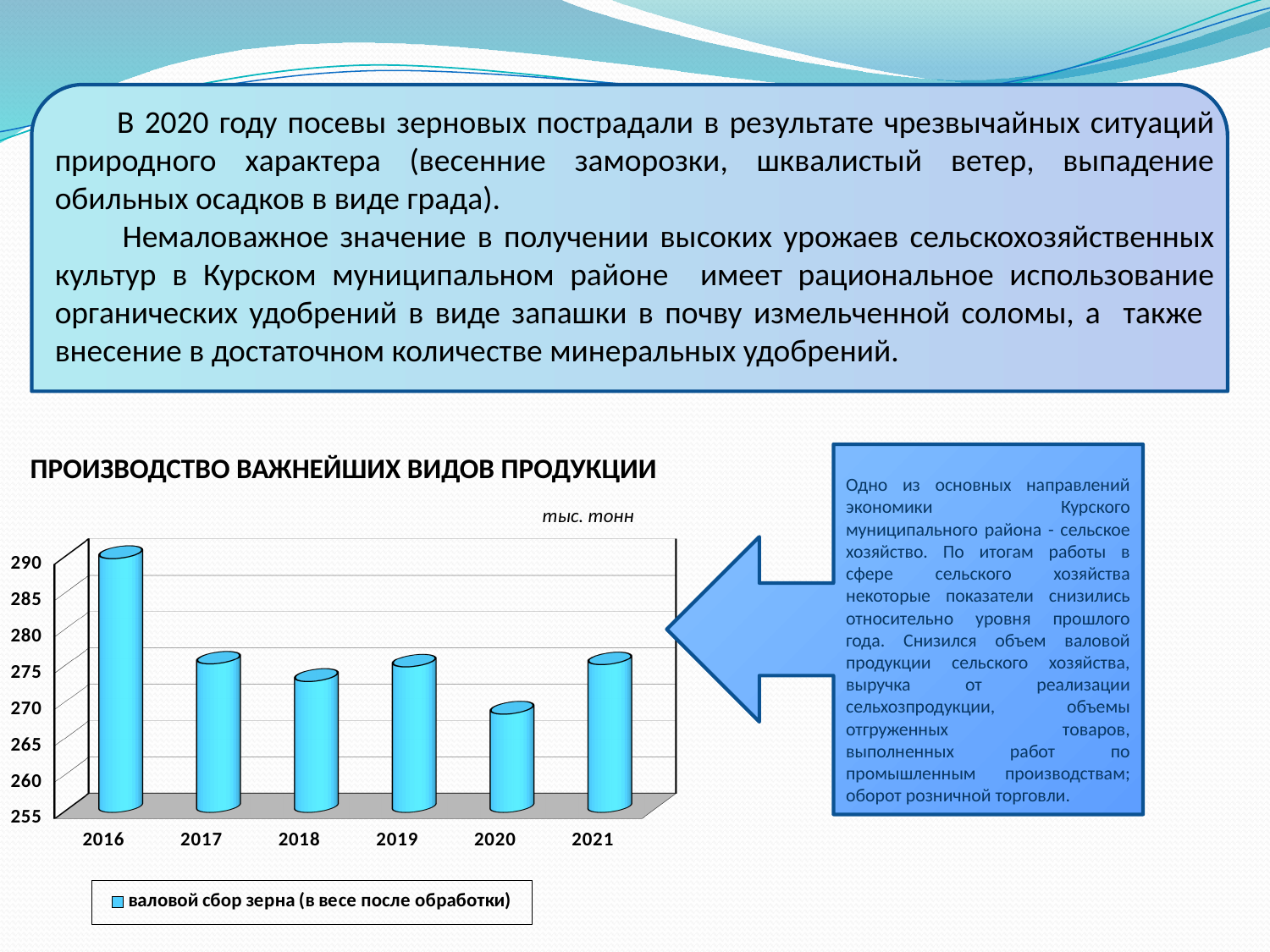
Does the value rise or fall from 2016 to 2017? fall What unit of measurement is indicated above the chart? тыс. тонн Which year has the lowest value in the chart? 2020 What kind of chart is shown on the slide? bar chart Is the value for 2017 greater or less than 280? less Which year has the larger value, 2018 or 2020? 2018 Which year has the highest value in the chart? 2016 Which year has the larger value, 2016 or 2020? 2016 How many series does the chart legend list? 1 How many years are shown on the x axis of the chart? 6 Is the value for 2016 greater or less than 285? greater Is the value for 2020 greater or less than 275? less